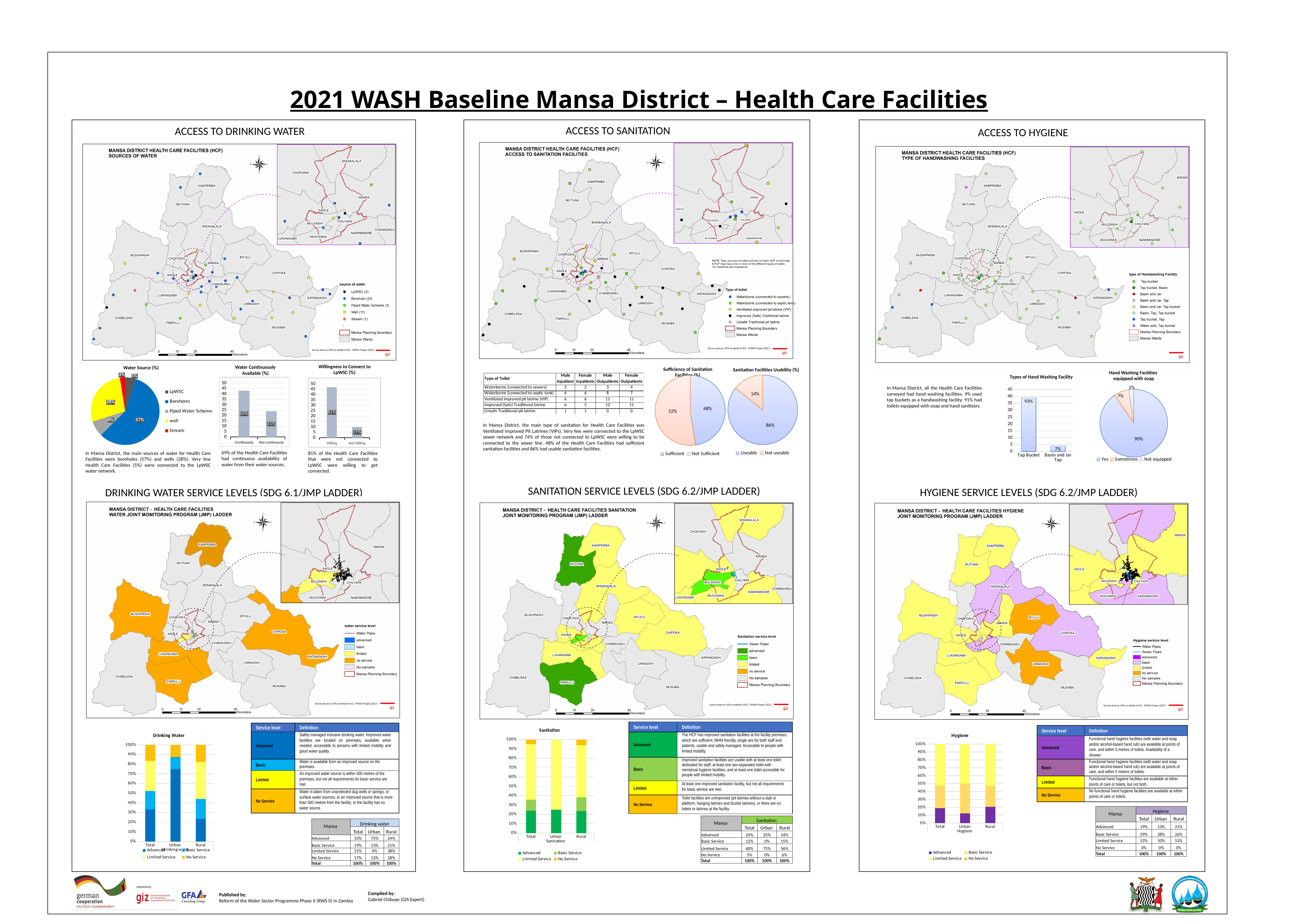
In the 'Water Source (%)' pie chart, what share is shown for well? 28% In the 'Sufficiency of Sanitation Facilities (%)' pie chart, what percentage is Not Sufficient? 52% In the 'Types of Hand Washing Facility' bar chart, what is the difference between Tap Bucket and Basin and Jar Tap? 86% In the 'Hand Washing Facilities equipped with soap' pie chart, which category has the smallest slice? Not equipped In the 'Willingness to Connect to LpWSC (%)' bar chart, which bar is taller, Willing or Not Willing? Willing In the 'Sanitation Facilities Usability (%)' pie chart, what percentage is Useable? 86% How many series does the legend of the 'Hygiene' stacked bar chart list? 4 In the 'Types of Hand Washing Facility' bar chart, what is the value for Tap Bucket? 93% In the 'Water Continuously Available (%)' bar chart, is the value for Continuously greater or less than 30? greater What kind of chart is the 'Drinking Water' chart at the bottom of the left panel? Stacked bar chart